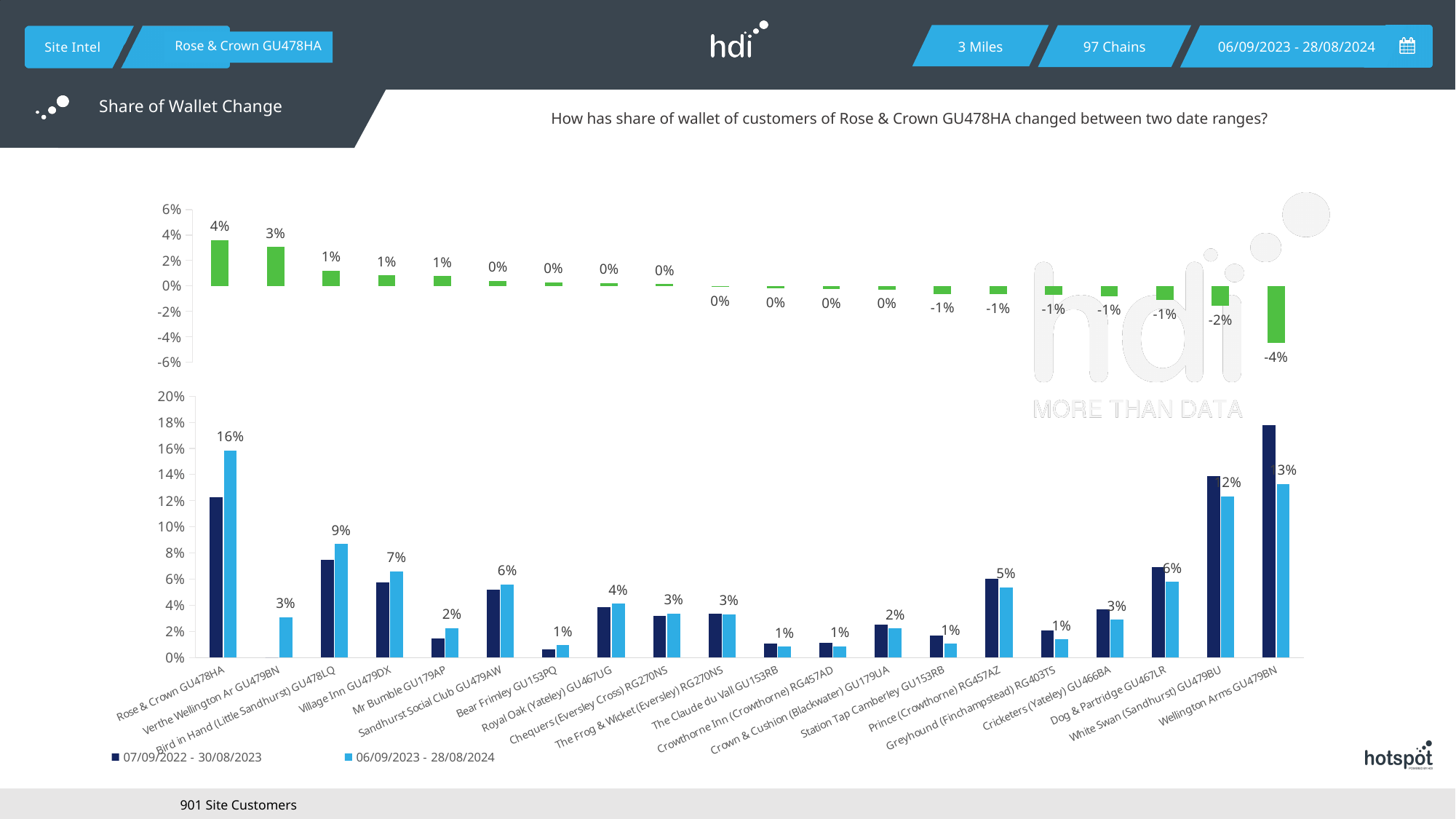
In the bottom chart, is the 07/09/2022 - 30/08/2023 value for Wellington Arms GU479BN greater or less than 16%? greater How many categories are shown on the x axis of the bottom chart? 20 How many series does the legend of the bottom chart list? 2 In the top chart, which category has the lowest share of wallet change? Wellington Arms GU479BN In the bottom chart, what is the 06/09/2023 - 28/08/2024 value for Prince (Crowthorne) RG457AZ? 5% In the top chart, what is the share of wallet change for Rose & Crown GU478HA? 4% In the top chart, what is the share of wallet change for White Swan (Sandhurst) GU479BU? -2% What kind of chart is the bottom chart? bar chart In the bottom chart, what is the 06/09/2023 - 28/08/2024 value for Bird in Hand (Little Sandhurst) GU478LQ? 9% In the bottom chart, what is the difference between the 06/09/2023 - 28/08/2024 values for Rose & Crown GU478HA and Wellington Arms GU479BN? 3% In the bottom chart, which has the larger 06/09/2023 - 28/08/2024 value: Rose & Crown GU478HA or Wellington Arms GU479BN? Rose & Crown GU478HA In the top chart, which category has the highest share of wallet change? Rose & Crown GU478HA